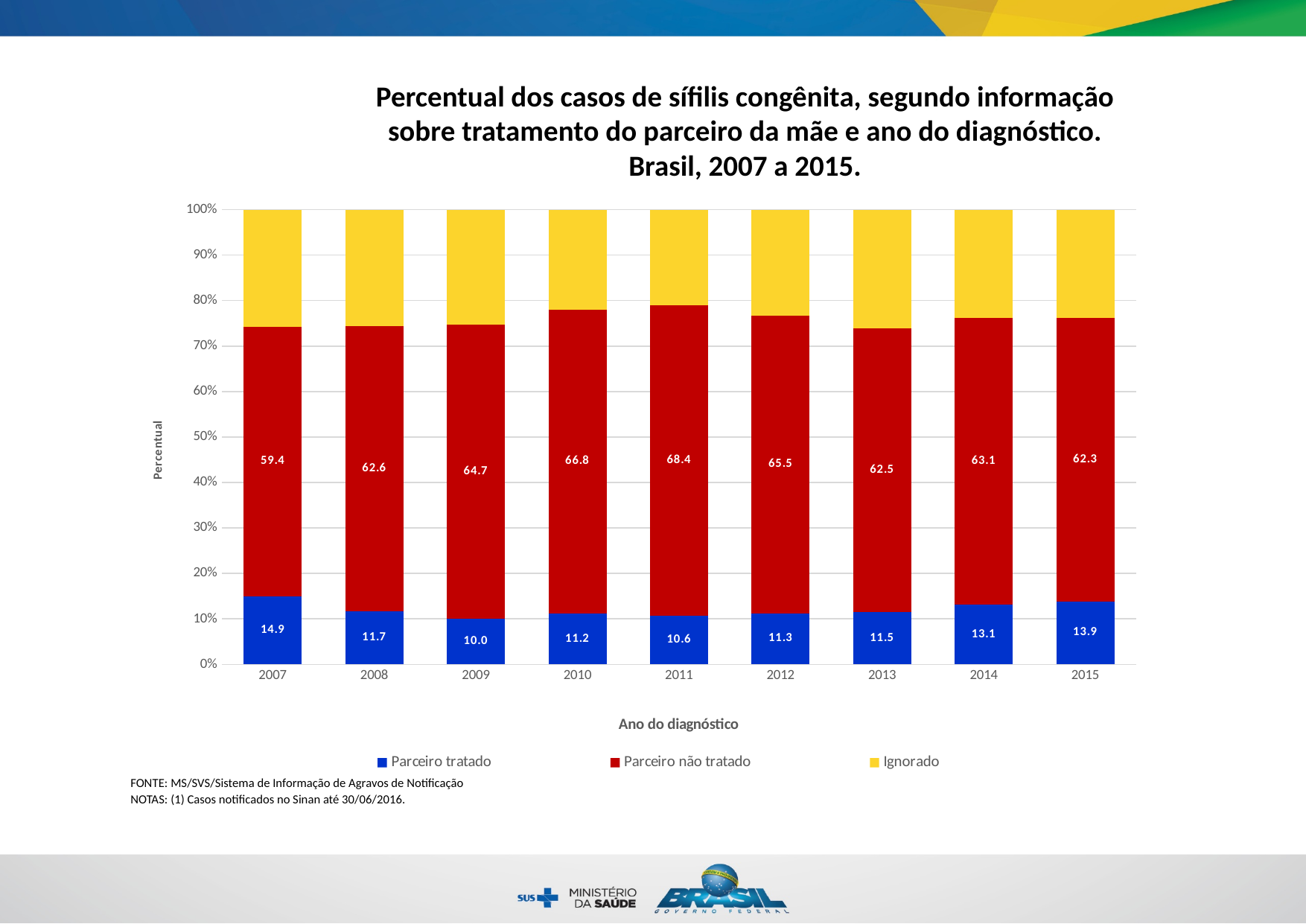
How many years are shown on the x axis? 9 What is the value for Parceiro tratado in 2012? 11.3 What kind of chart is shown on the slide? Stacked bar chart Is the Ignorado value for 2011 greater or less than 30%? less In which year is the Parceiro tratado value highest? 2007 What is the value for Parceiro tratado in 2007? 14.9 How many series does the legend list? 3 What is the value for Parceiro não tratado in 2011? 68.4 Which year has the larger Parceiro tratado value, 2014 or 2015? 2015 In which year is the Parceiro tratado value lowest? 2009 In which year is the Parceiro não tratado value highest? 2011 What is the difference between the Parceiro não tratado values for 2011 and 2007? 9.0